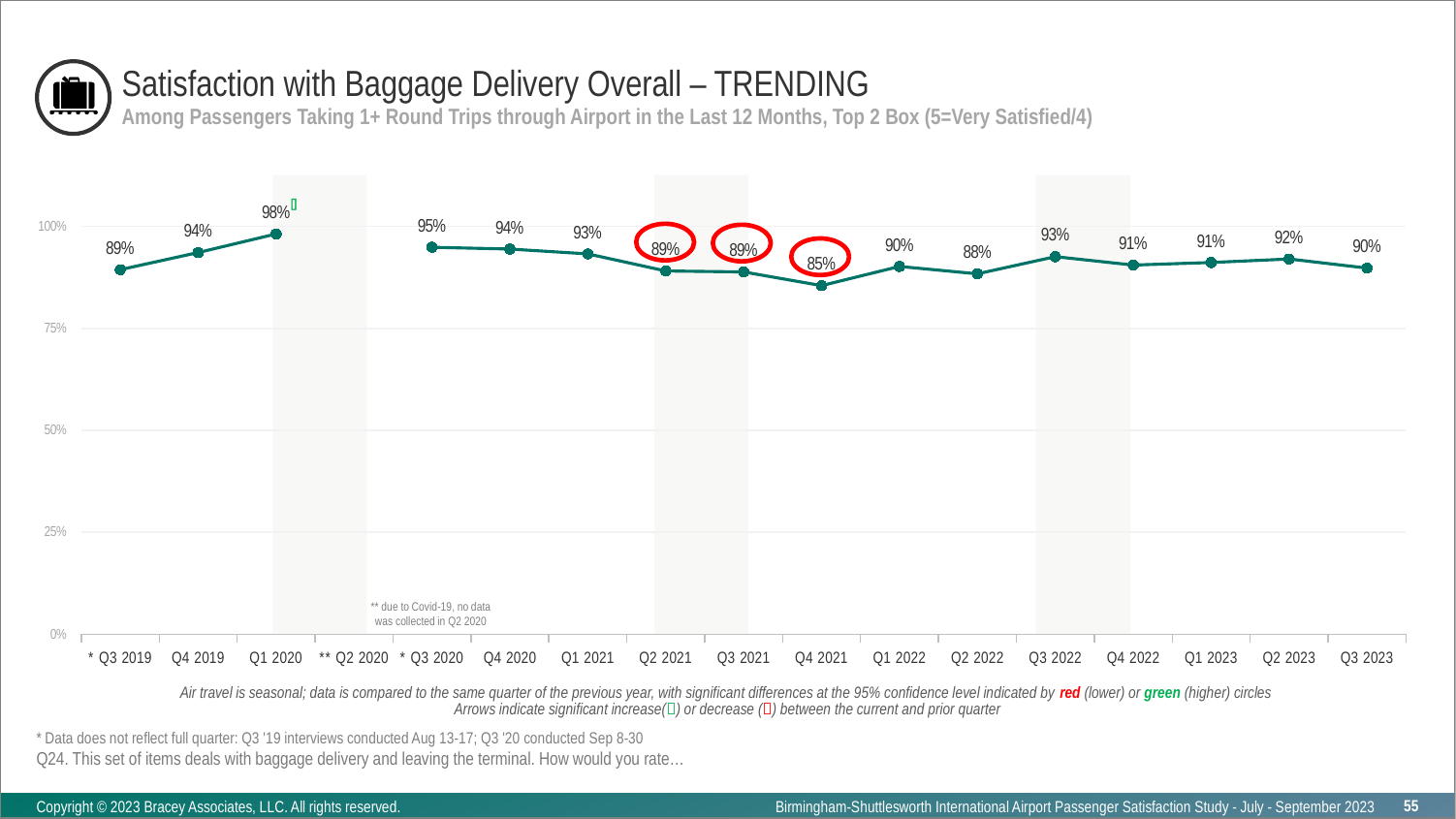
How many quarters have a plotted data point on the chart? 16 What type of chart is shown on the slide? Line chart What is the satisfaction value for Q3 2023? 90% Which quarter has the lowest satisfaction value? Q4 2021 What is the satisfaction value for Q4 2021? 85% What is the difference between the values for Q1 2020 and Q4 2021? 13 percentage points Which is larger, the value for Q4 2019 or the value for Q2 2022? Q4 2019 What is the satisfaction value for Q1 2020? 98% What is the satisfaction value for Q3 2022? 93% How many data points are marked with a red circle? 3 Which quarter has no data collected, according to the chart? Q2 2020 Which quarter has the highest satisfaction value? Q1 2020